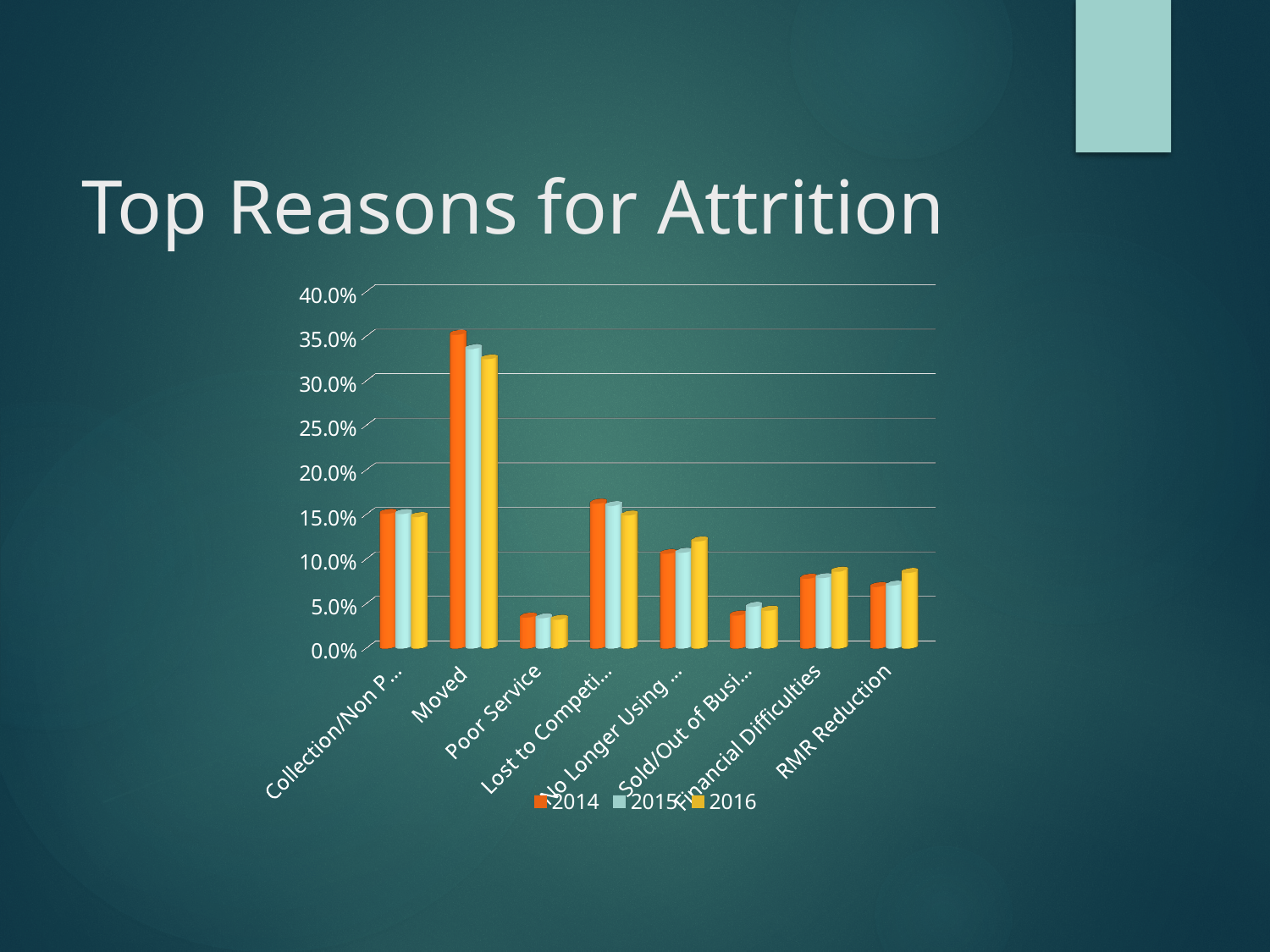
For Moved, which is larger: the 2014 value or the 2016 value? 2014 What is the title of the chart? Top Reasons for Attrition Which series is shown in orange? 2014 Is the 2014 value for RMR Reduction greater or less than 10.0%? less Is the 2014 value for Moved greater or less than 30.0%? greater Is the 2014 value for Poor Service greater or less than 5.0%? less How many categories are shown on the x axis? 8 Which category has the highest values across all years? Moved Which is larger for 2015: Moved or Poor Service? Moved What kind of chart is shown on the slide? bar chart How many series does the legend list? 3